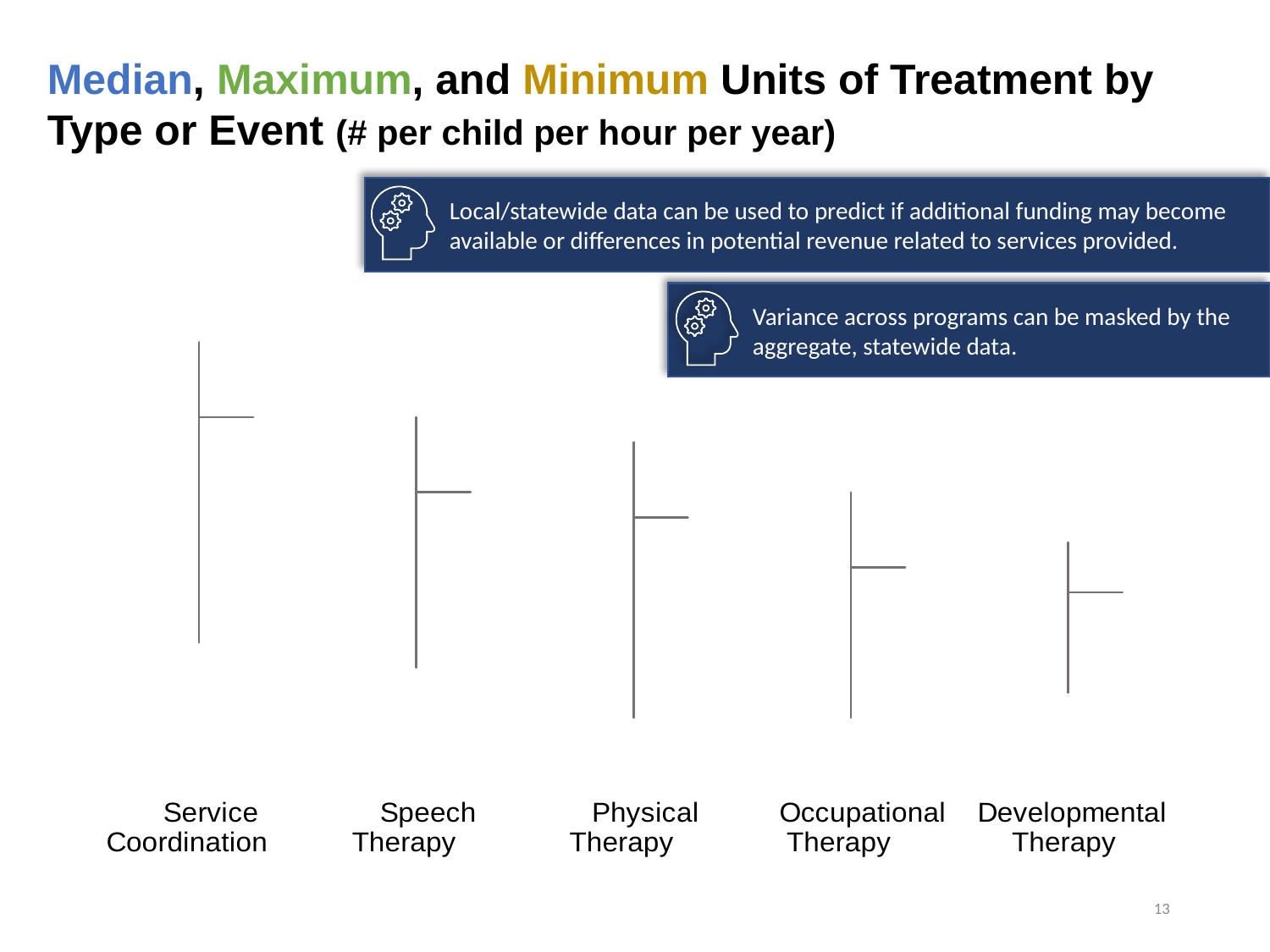
Which has the higher median marker, Occupational Therapy or Developmental Therapy? Occupational Therapy Which category's vertical range line reaches the highest point on the chart? Service Coordination Do the median markers rise or fall moving from left to right across the categories? fall How many treatment types or events are shown along the x axis of the chart? 5 According to the chart title, in what unit are the units of treatment expressed? # per child per hour per year Which treatment type has the lowest median marker in the chart? Developmental Therapy What is the category label of the third item from the left on the x axis? Physical Therapy Which has the higher median marker, Speech Therapy or Physical Therapy? Speech Therapy Which treatment type has the highest median marker in the chart? Service Coordination